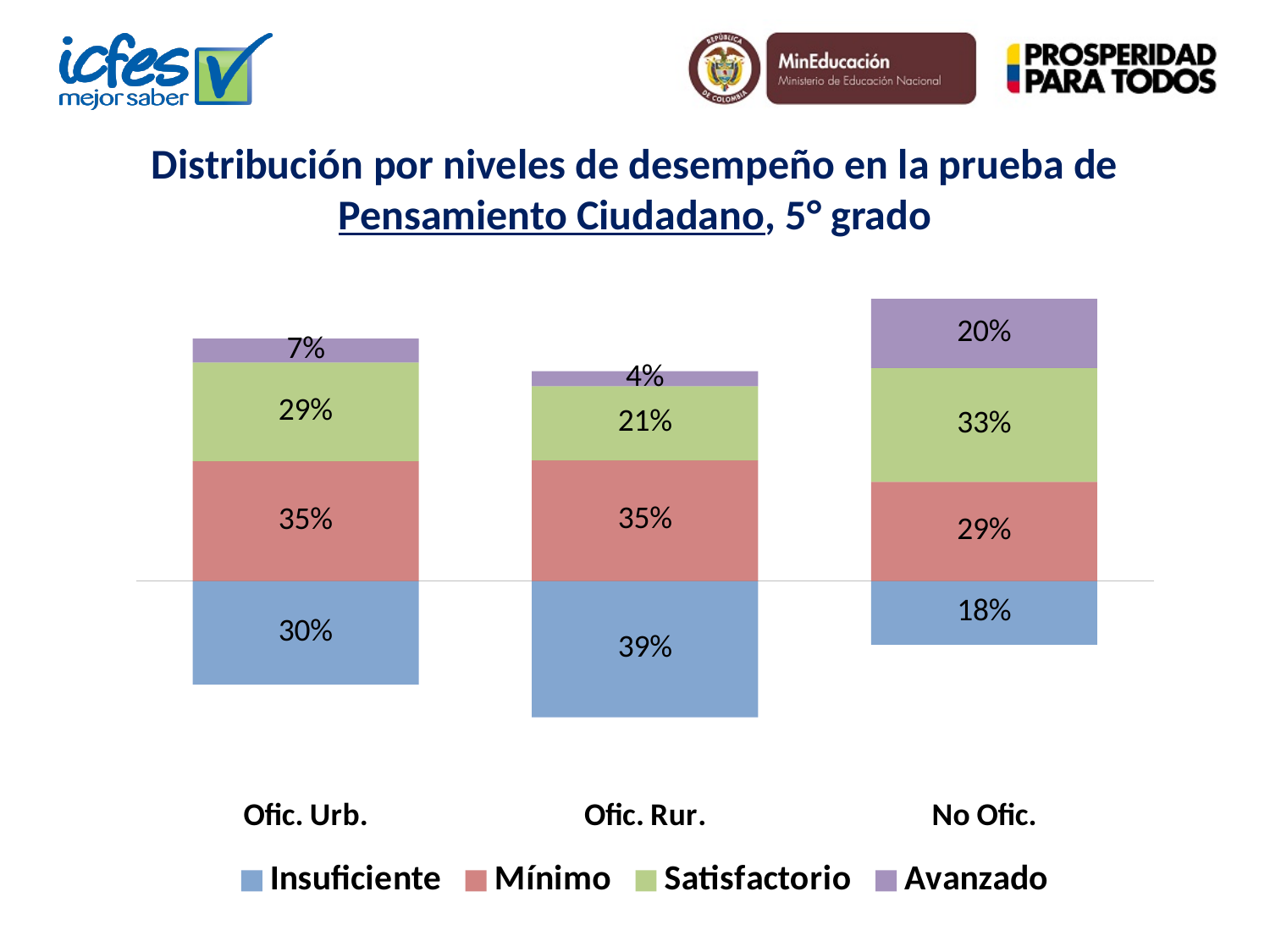
Which category has the lowest Insuficiente value? No Ofic. What is the Mínimo value for No Ofic.? 29% What is the Satisfactorio value for Ofic. Urb.? 29% Which series is shown in purple in the legend? Avanzado What is the Avanzado value for No Ofic.? 20% What is the difference between the Satisfactorio values for No Ofic. and Ofic. Rur.? 12% What type of chart is shown on the slide? Stacked bar chart Which is larger, the Insuficiente value for Ofic. Urb. or for Ofic. Rur.? Ofic. Rur. How many series does the legend list? 4 What is the Insuficiente value for Ofic. Rur.? 39% Which category has the highest Avanzado value? No Ofic. How many categories are shown on the x axis? 3